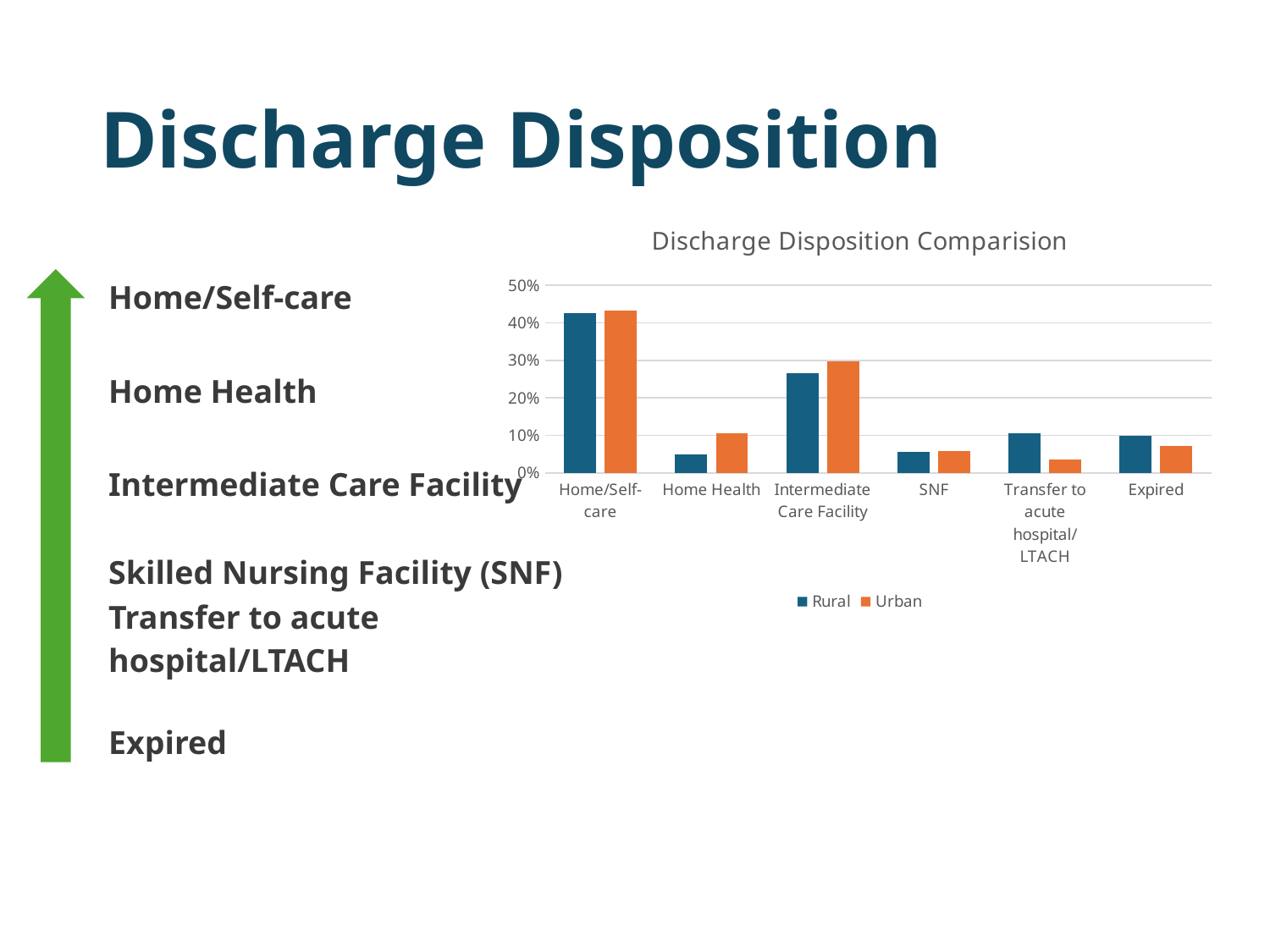
Is the Rural value for Intermediate Care Facility greater or less than 20%? greater Is the Rural value for Home Health greater or less than 10%? less Which category has the highest Urban value? Home/Self-care Which category has the highest Rural value? Home/Self-care How many series does the chart legend list? 2 Is the Rural value for Home/Self-care greater or less than 40%? greater What kind of chart is shown on the slide? bar chart How many discharge disposition categories are shown on the x axis? 6 For Transfer to acute hospital/LTACH, which is larger, the Rural or the Urban value? Rural What is the title of the chart? Discharge Disposition Comparision For Home Health, which is larger, the Rural or the Urban value? Urban